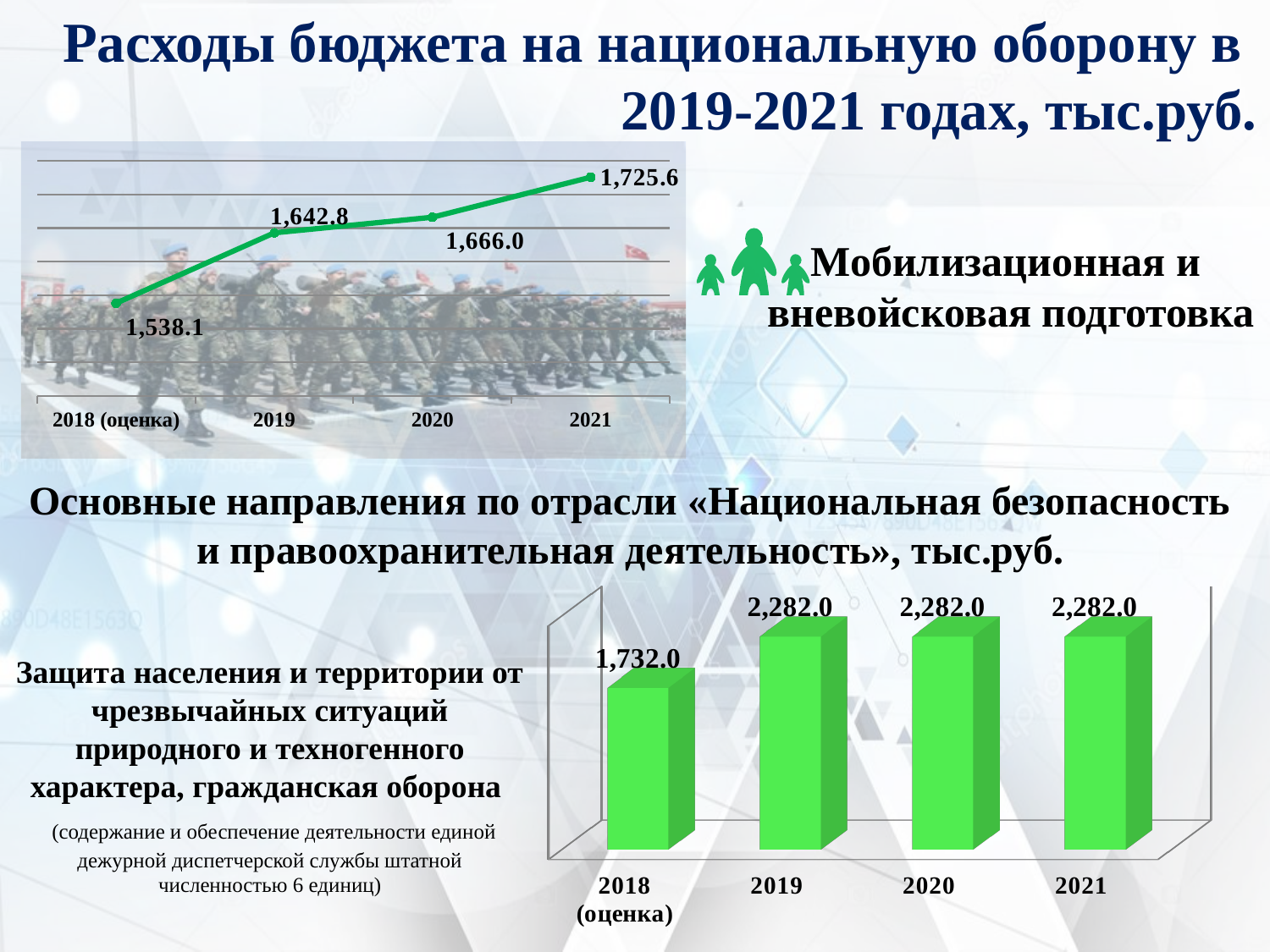
What type of chart is shown at the top left of the slide? line chart On the line chart at the top of the slide, what is the value for 2021? 1,725.6 On the bar chart at the bottom of the slide, what is the difference between the 2019 value and the 2018 (оценка) value? 550.0 On the line chart at the top of the slide, do the values rise or fall from 2018 to 2021? rise On the bar chart at the bottom of the slide, what is the value for 2020? 2,282.0 What type of chart is shown at the bottom right of the slide? bar chart On the bar chart at the bottom of the slide, what is the value for 2018 (оценка)? 1,732.0 On the line chart at the top of the slide, how many data points are plotted? 4 On the bar chart at the bottom of the slide, which year has the lowest value? 2018 (оценка) On the line chart at the top of the slide, what is the difference between the 2021 value and the 2018 (оценка) value? 187.5 On the line chart at the top of the slide, what is the value for 2018 (оценка)? 1,538.1 On the line chart at the top of the slide, which year has the lowest value? 2018 (оценка)